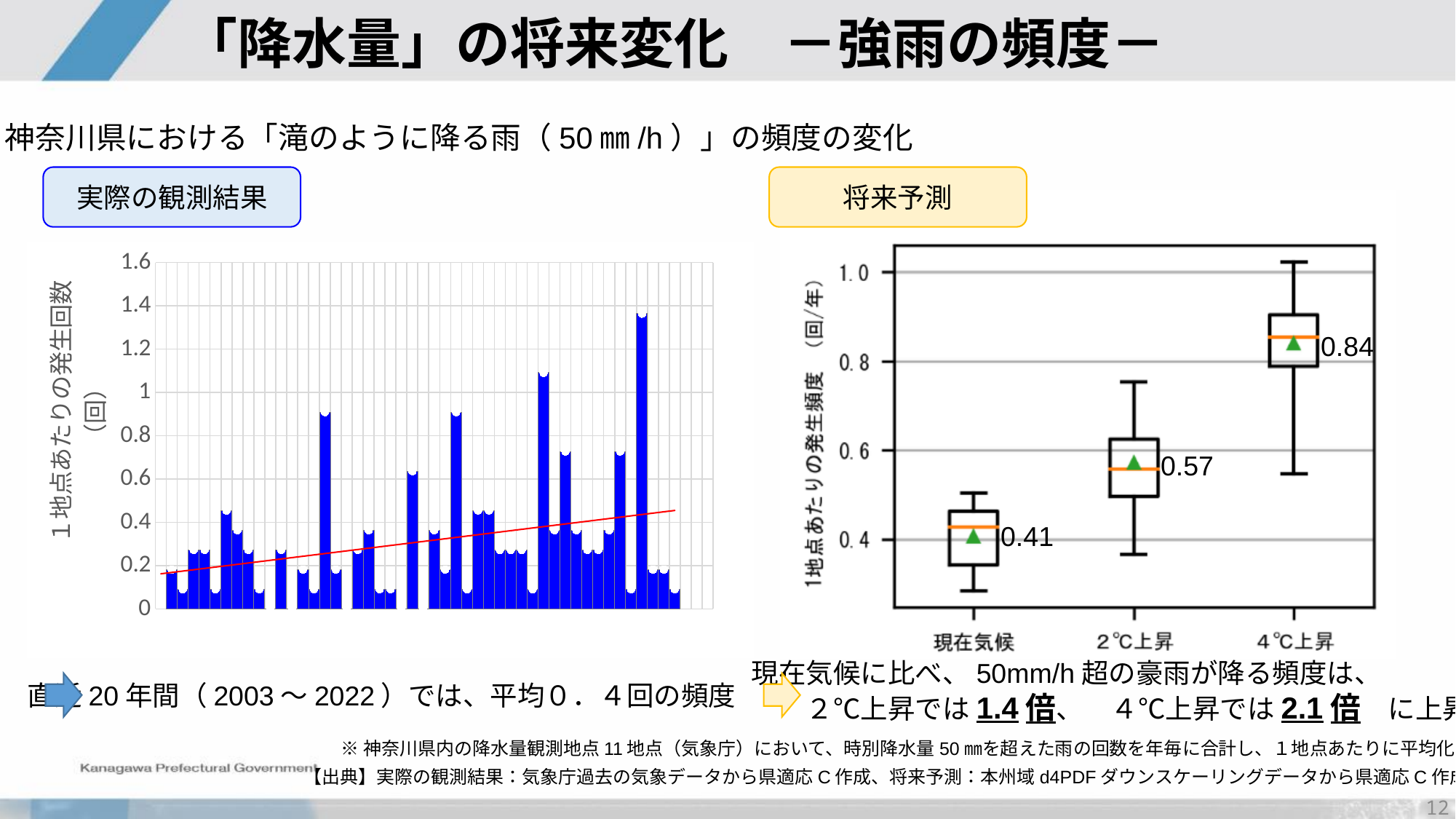
What kind of chart is the left chart under 実際の観測結果? bar chart In the right chart under 将来予測, which category has the lowest labelled value? 現在気候 In the right chart under 将来予測, what is the labelled value for 2℃上昇? 0.57 In the right chart under 将来予測, is the labelled value for 4℃上昇 greater or less than 0.8? greater In the left bar chart, is the tallest bar greater or less than 1.2? greater In the right chart under 将来予測, what is the labelled value for 現在気候? 0.41 In the right chart under 将来予測, what is the difference between the labelled values for 4℃上昇 and 現在気候? 0.43 In the right chart under 将来予測, which is larger, the labelled value for 2℃上昇 or for 現在気候? 2℃上昇 In the right chart under 将来予測, what is the labelled value for 4℃上昇? 0.84 In the left bar chart, does the red trend line rise or fall from left to right? rise In the right chart under 将来予測, how many categories are shown on the x axis? 3 In the right chart under 将来予測, which category has the highest labelled value? 4℃上昇